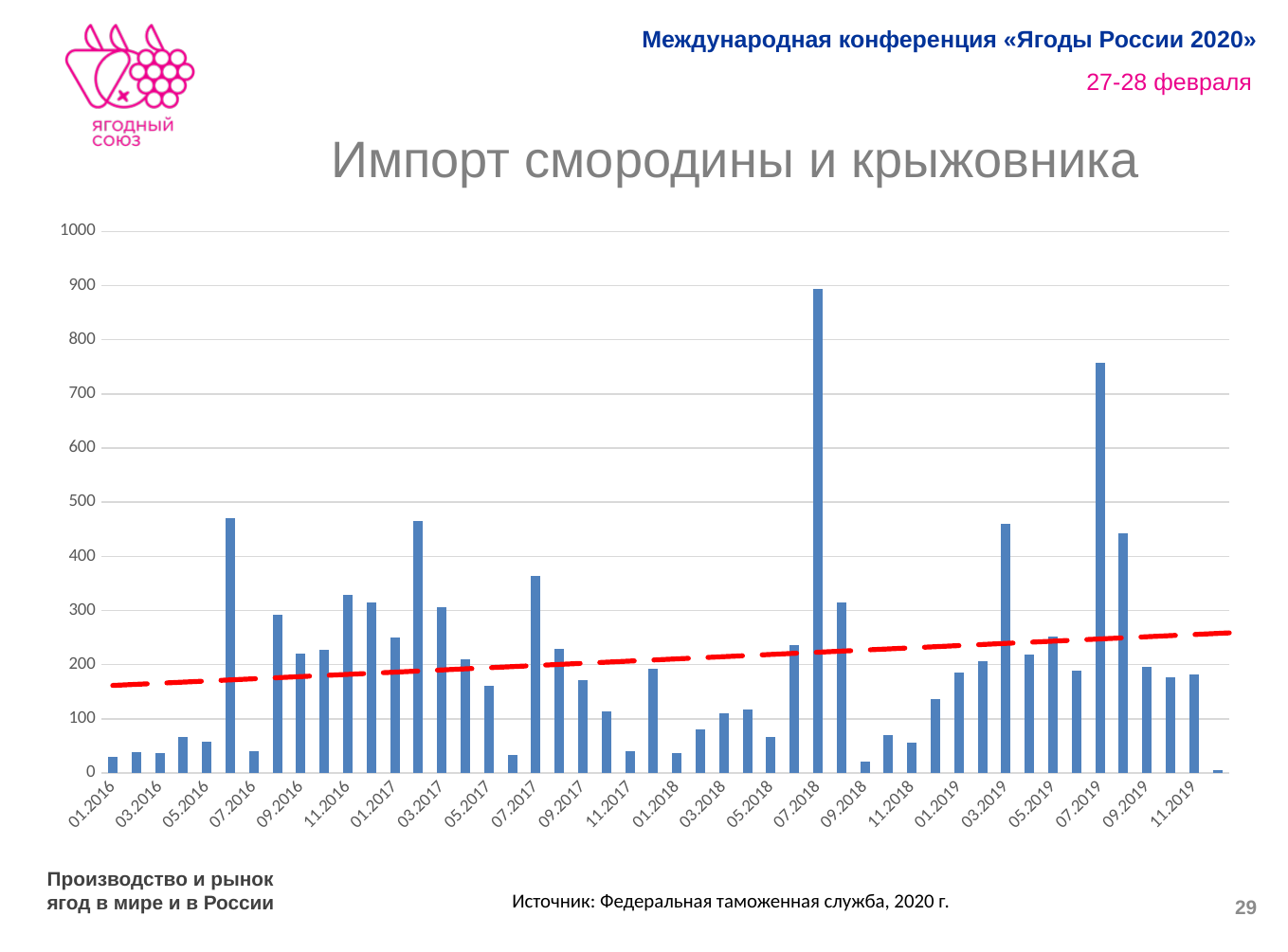
Is the value for 07.2017 greater or less than 300? greater What is the title of the chart? Импорт смородины и крыжовника Does the dashed trend line rise or fall from left to right across the chart? rises Is the value for 07.2018 greater or less than 800? greater Is the value for 07.2016 greater or less than 400? less Which is larger, the value for 07.2016 or the value for 01.2016? 07.2016 Which is larger, the value for 07.2018 or the value for 07.2019? 07.2018 What kind of chart is shown on the slide? bar chart Which month has the highest bar in the chart? 07.2018